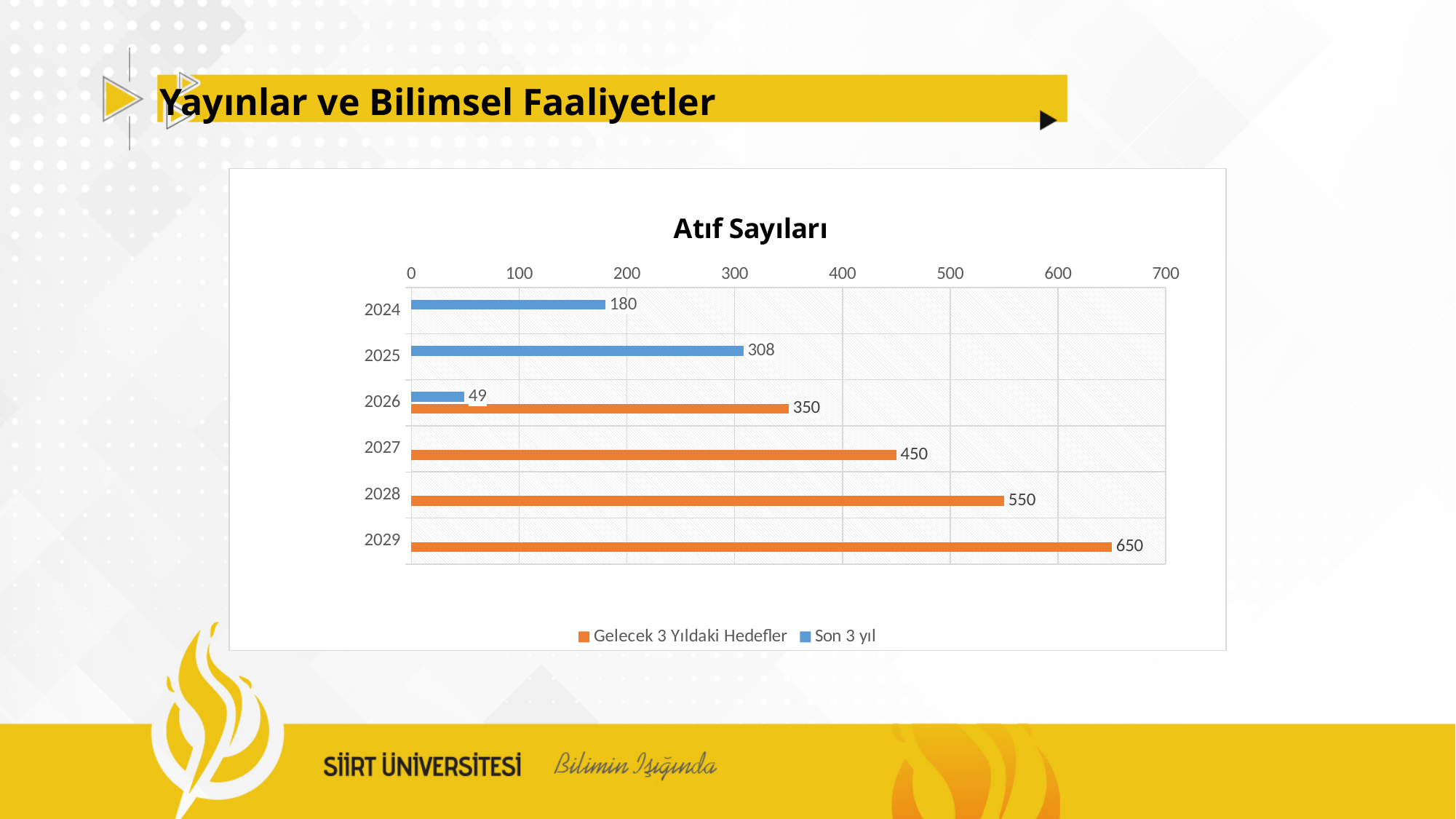
Do the 'Gelecek 3 Yıldaki Hedefler' values rise or fall from 2026 to 2029? rise What is the value for 'Son 3 yıl' in 2026? 49 How many year categories are shown on the chart? 6 What type of chart is shown on the slide? bar chart Which year has the highest value for 'Gelecek 3 Yıldaki Hedefler'? 2029 How many series does the legend list? 2 What is the difference between the 'Son 3 yıl' values for 2025 and 2024? 128 Which year has the lowest value for 'Son 3 yıl'? 2026 What is the title of the chart? Atıf Sayıları What is the value for 'Gelecek 3 Yıldaki Hedefler' in 2028? 550 Which is larger in 2026: 'Gelecek 3 Yıldaki Hedefler' or 'Son 3 yıl'? Gelecek 3 Yıldaki Hedefler What is the value for 'Son 3 yıl' in 2025? 308